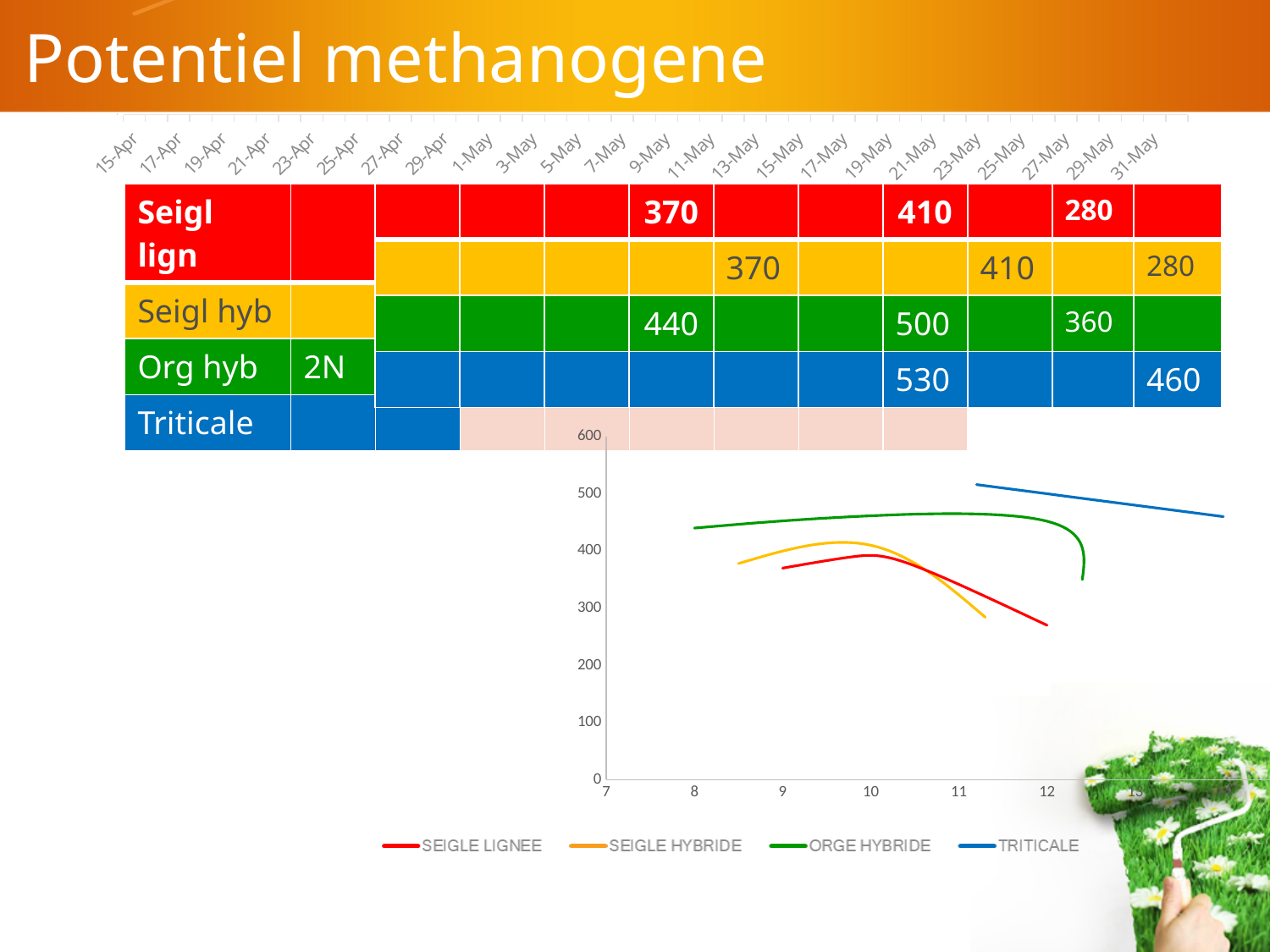
Is the value for SEIGLE LIGNEE at x = 12 greater or less than 300? less Does the SEIGLE HYBRIDE line rise or fall between x = 10 and x = 11? fall How many series does the chart legend list? 4 Which series reaches the highest value on the chart? TRITICALE What is the highest value shown on the chart's y axis? 600 At x = 10, which series has the larger value, ORGE HYBRIDE or SEIGLE LIGNEE? ORGE HYBRIDE Does the TRITICALE line rise or fall between x = 11 and x = 13? fall Is the value for SEIGLE HYBRIDE at x = 11 greater or less than 400? less Which series are listed in the chart legend? SEIGLE LIGNEE, SEIGLE HYBRIDE, ORGE HYBRIDE, TRITICALE Is the value for TRITICALE at x = 12 greater or less than 400? greater What kind of chart is shown on the slide? line chart